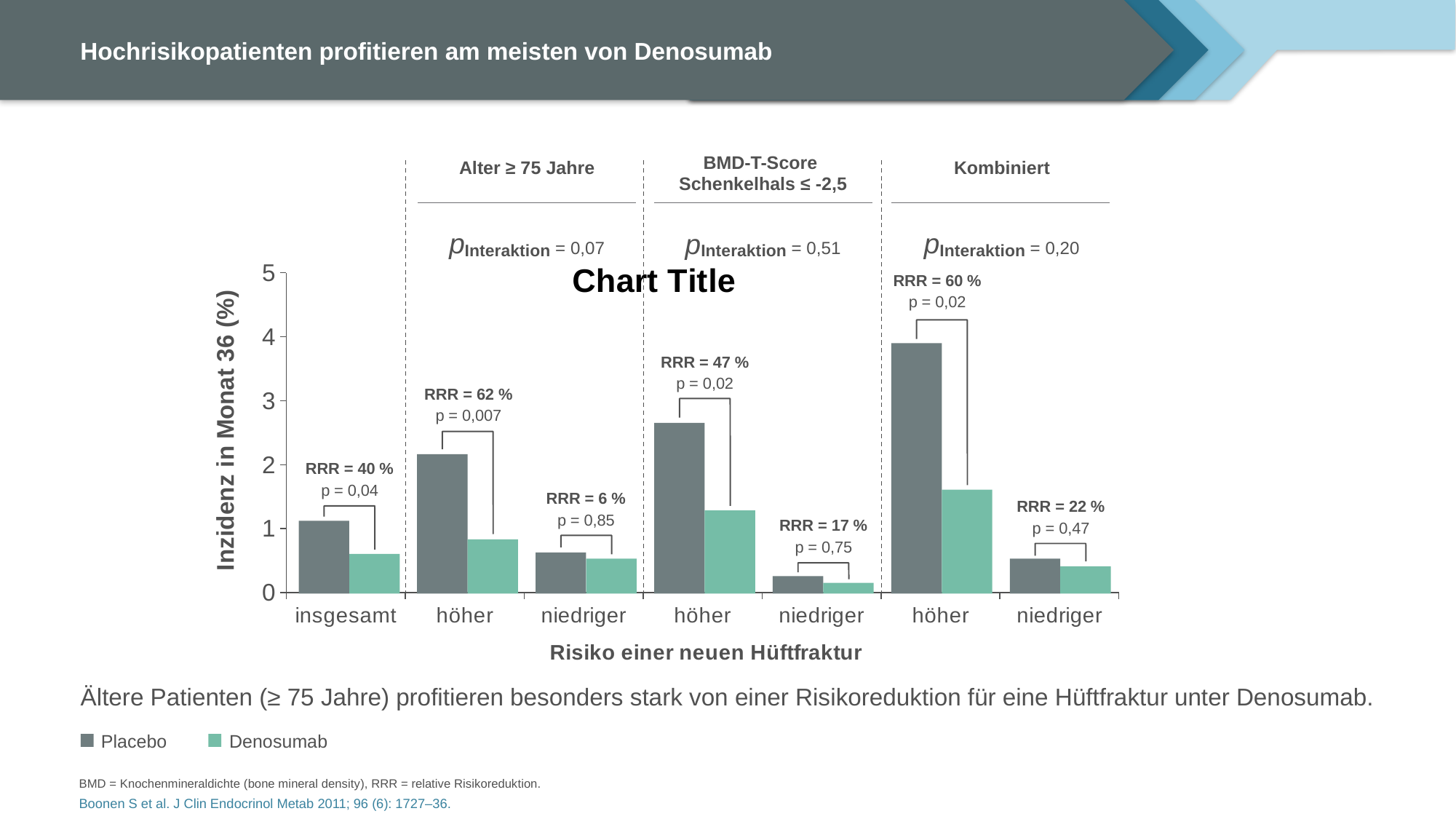
How many categories are shown along the x axis of the chart? 7 How many series does the chart legend list? 2 Is the Placebo value for 'höher' in the 'Alter ≥ 75 Jahre' group greater or less than 2? greater Is the Placebo value for 'höher' in the 'Kombiniert' group greater or less than 3? greater What is the title of the y axis? Inzidenz in Monat 36 (%) Is the Denosumab value for 'höher' in the 'BMD-T-Score Schenkelhals ≤ -2,5' group greater or less than 2? less Which bar in the chart is the highest? Placebo, höher (Kombiniert) Which two series are listed in the chart legend? Placebo and Denosumab Which bar in the chart is the lowest? Denosumab, niedriger (BMD-T-Score Schenkelhals ≤ -2,5) For the category 'insgesamt', which is larger: the Placebo bar or the Denosumab bar? Placebo What RRR is printed above the 'höher' bars in the 'Alter ≥ 75 Jahre' group? RRR = 62 % What type of chart is shown on the slide? bar chart